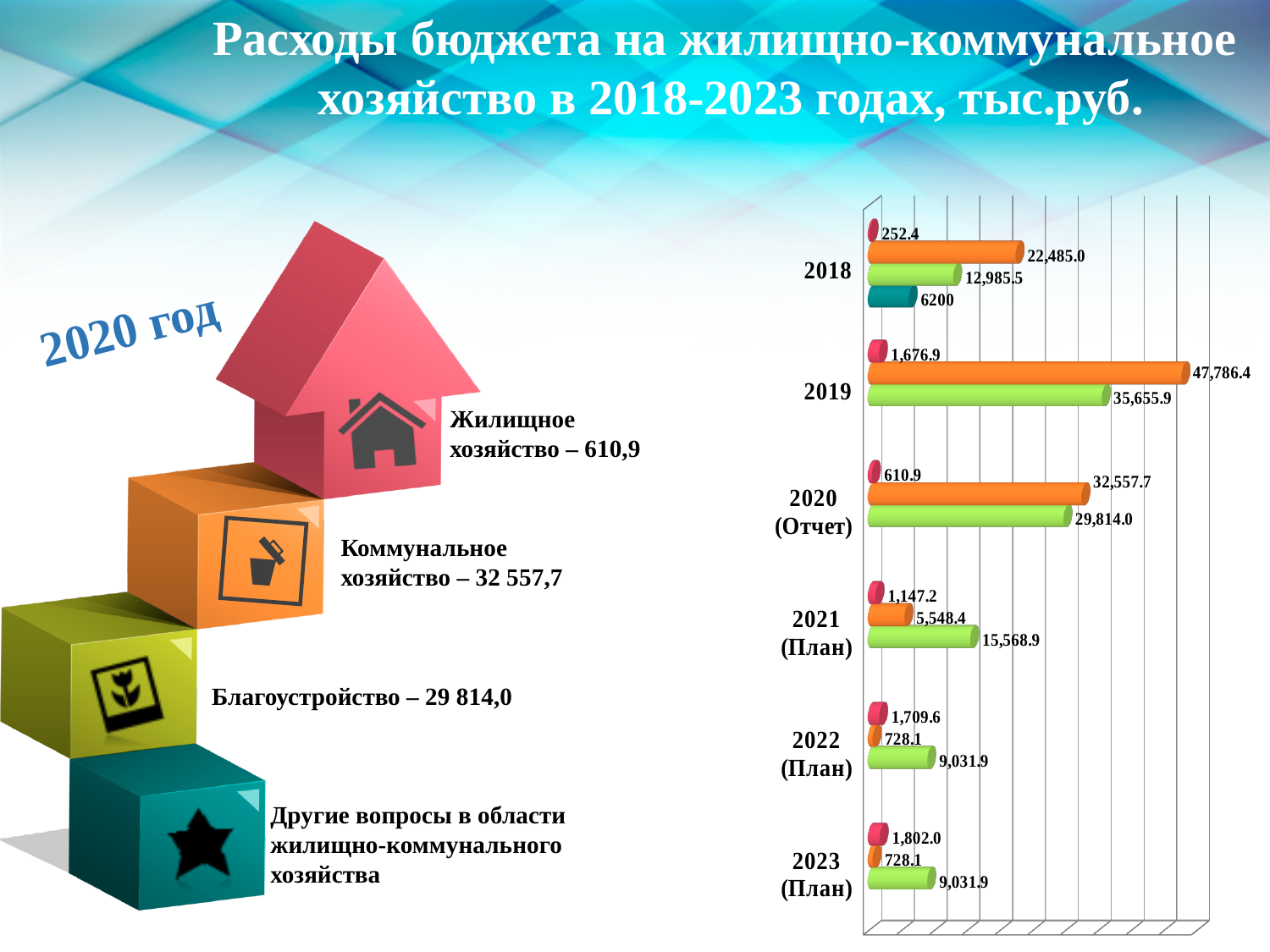
Does the pink bar rise or fall from 2021 (План) to 2023 (План)? rises What is the value of the green bar for 2020 (Отчет) in the chart? 29,814.0 What is the value of the teal bar for 2018 in the chart? 6200 For 2021 (План), which is larger: the green bar or the orange bar? the green bar In which year is the orange bar the longest in the chart? 2019 What kind of chart is shown on the right side of the slide? bar chart How many year categories does the chart on the right show? 6 What is the value of the pink bar for 2023 (План) in the chart? 1,802.0 What is the value of the orange bar for 2019 in the chart? 47,786.4 What is the difference between the orange bar and the green bar for 2020 (Отчет)? 2,743.7 In which year is the pink bar the shortest in the chart? 2018 According to the slide, which category does the orange colour represent? Коммунальное хозяйство